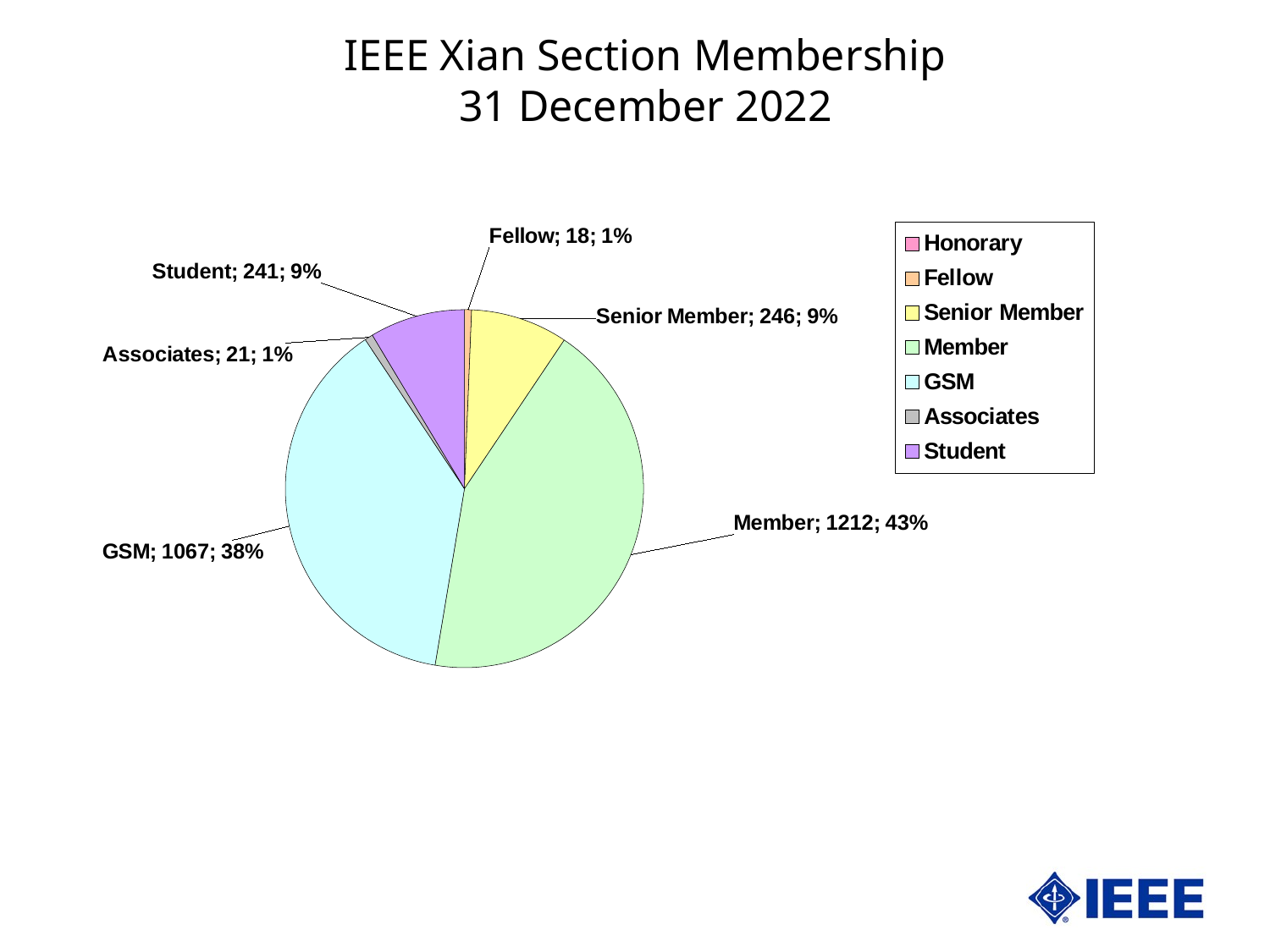
Which category has the largest slice of the pie? Member What percentage share does the GSM slice have? 38% How many members does the Member slice represent? 1212 Which labelled category has the smallest value, Fellow or Associates? Fellow How many entries does the legend list? 7 What is the title of the chart? IEEE Xian Section Membership 31 December 2022 What is the value shown for Associates? 21 Which is larger, the Senior Member count or the Student count? Senior Member What percentage share does the Senior Member slice have? 9% What kind of chart is shown on the slide? pie chart What is the value shown for GSM? 1067 What is the difference between the Member count and the GSM count? 145